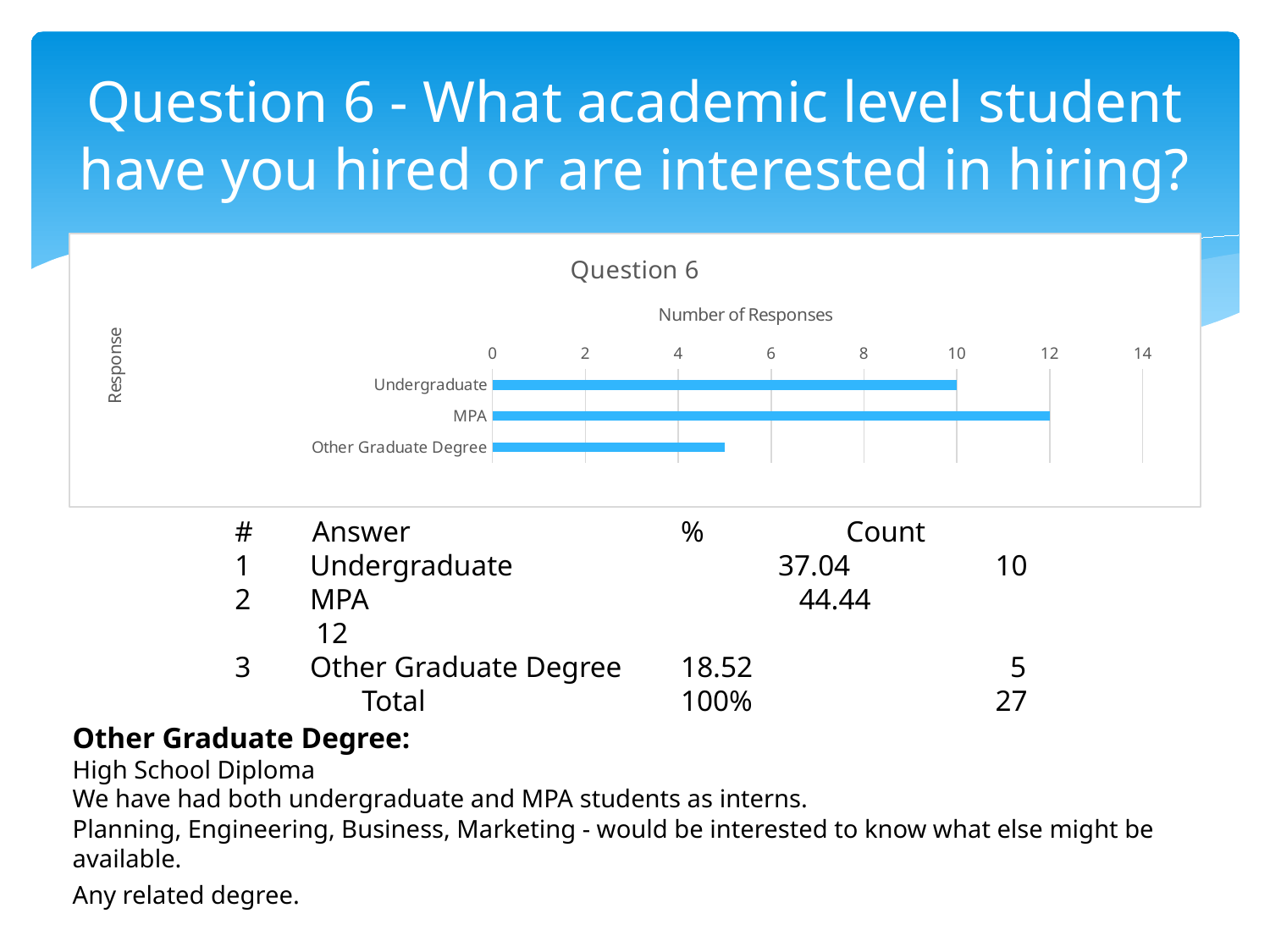
What type of chart is shown on the slide? bar chart What is the title of the chart? Question 6 What is the number of responses for MPA? 12 Which has more responses, Undergraduate or MPA? MPA What is the label of the horizontal axis? Number of Responses Which category has the highest number of responses? MPA Is the value for Other Graduate Degree greater or less than 8? less What is the number of responses for Other Graduate Degree? 5 How many categories are plotted in the chart? 3 Which category has the lowest number of responses? Other Graduate Degree What is the difference in responses between MPA and Undergraduate? 2 What is the number of responses for Undergraduate? 10